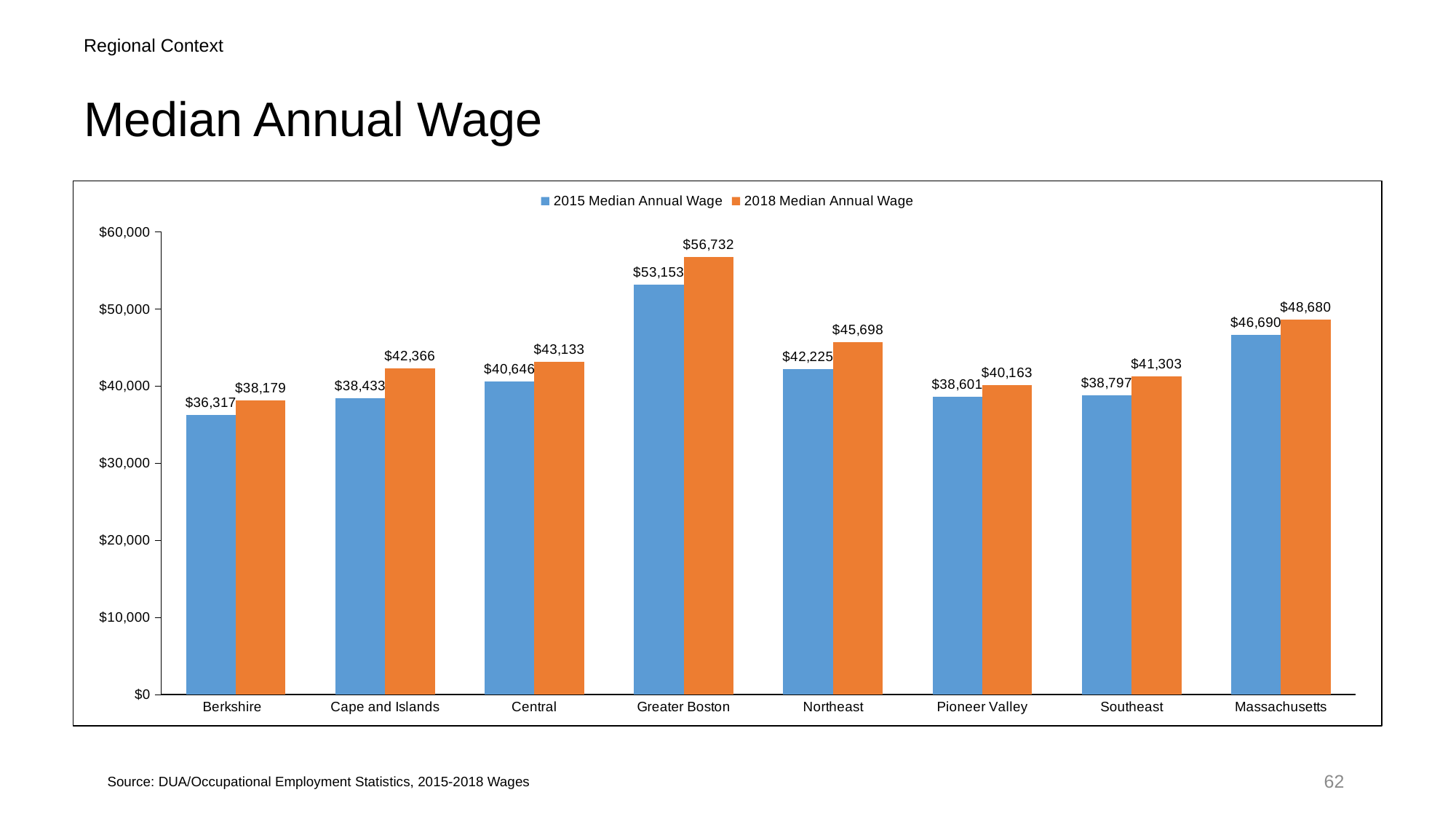
Which region has the highest 2018 Median Annual Wage? Greater Boston How many series does the chart's legend list? 2 How many regions are shown on the x axis of the chart? 8 What was the 2018 Median Annual Wage for Northeast? $45,698 Which region has the lowest 2015 Median Annual Wage? Berkshire What was the 2015 Median Annual Wage for Berkshire? $36,317 Is the 2018 Median Annual Wage for Southeast greater or less than $40,000? greater Which is larger: the 2015 Median Annual Wage for Central or the 2015 Median Annual Wage for Pioneer Valley? Central What is the difference between the 2018 and 2015 Median Annual Wage for Massachusetts? $1,990 What is the difference between the 2018 and 2015 Median Annual Wage for Greater Boston? $3,579 What was the 2018 Median Annual Wage for Cape and Islands? $42,366 What kind of chart is shown on the slide? Bar chart